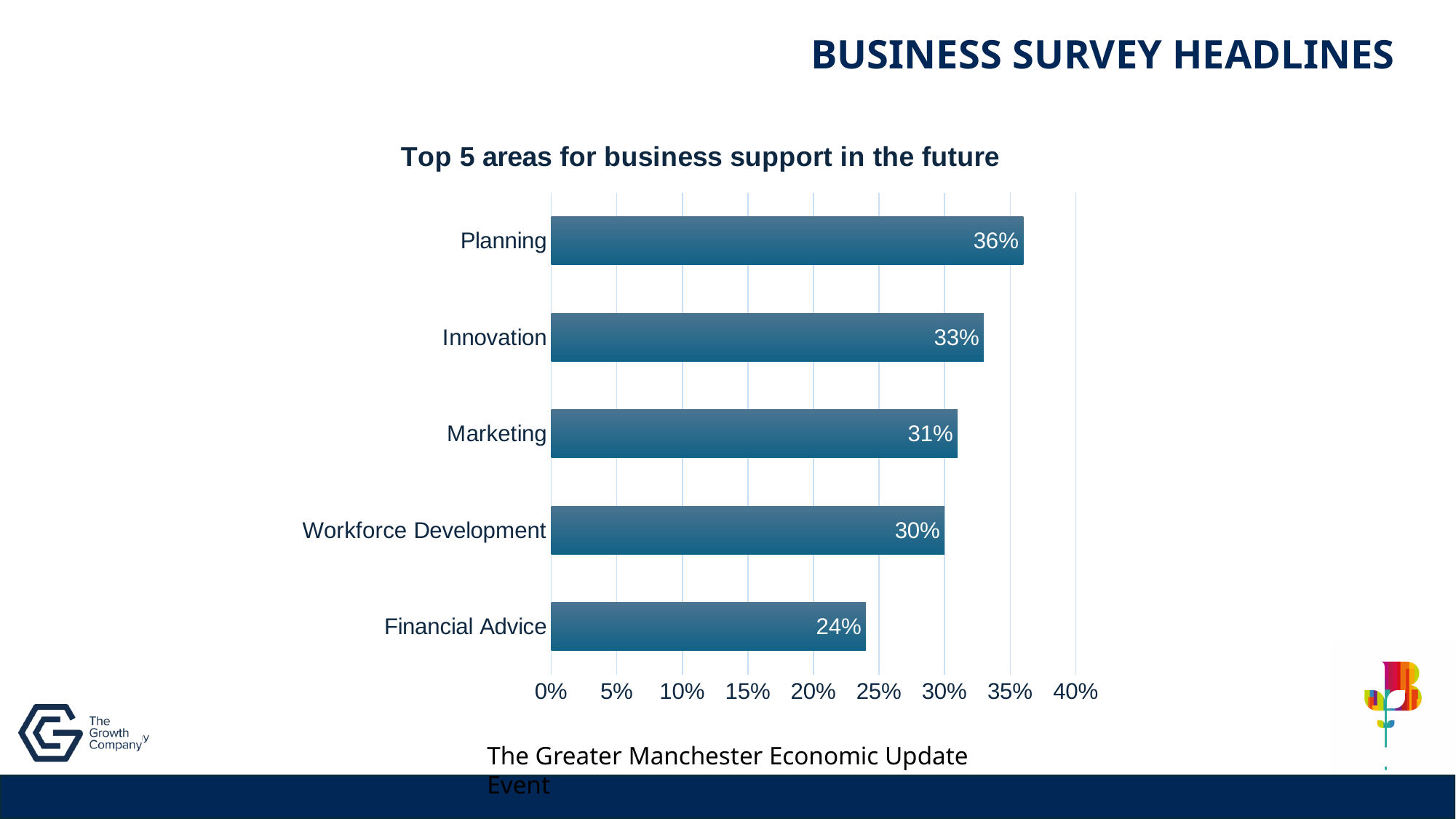
Which area has the lowest value? Financial Advice Which is larger, the value for Innovation or the value for Workforce Development? Innovation What is the difference between the values for Planning and Financial Advice? 12% Is the value for Marketing greater or less than 25%? greater What is the difference between the values for Innovation and Marketing? 2% Which area has the highest value? Planning What is the value for Workforce Development? 30% How many areas are shown in the chart? 5 What is the value for Financial Advice? 24% What kind of chart is shown on the slide? Bar chart What is the value for Planning? 36% What is the title of the chart? Top 5 areas for business support in the future